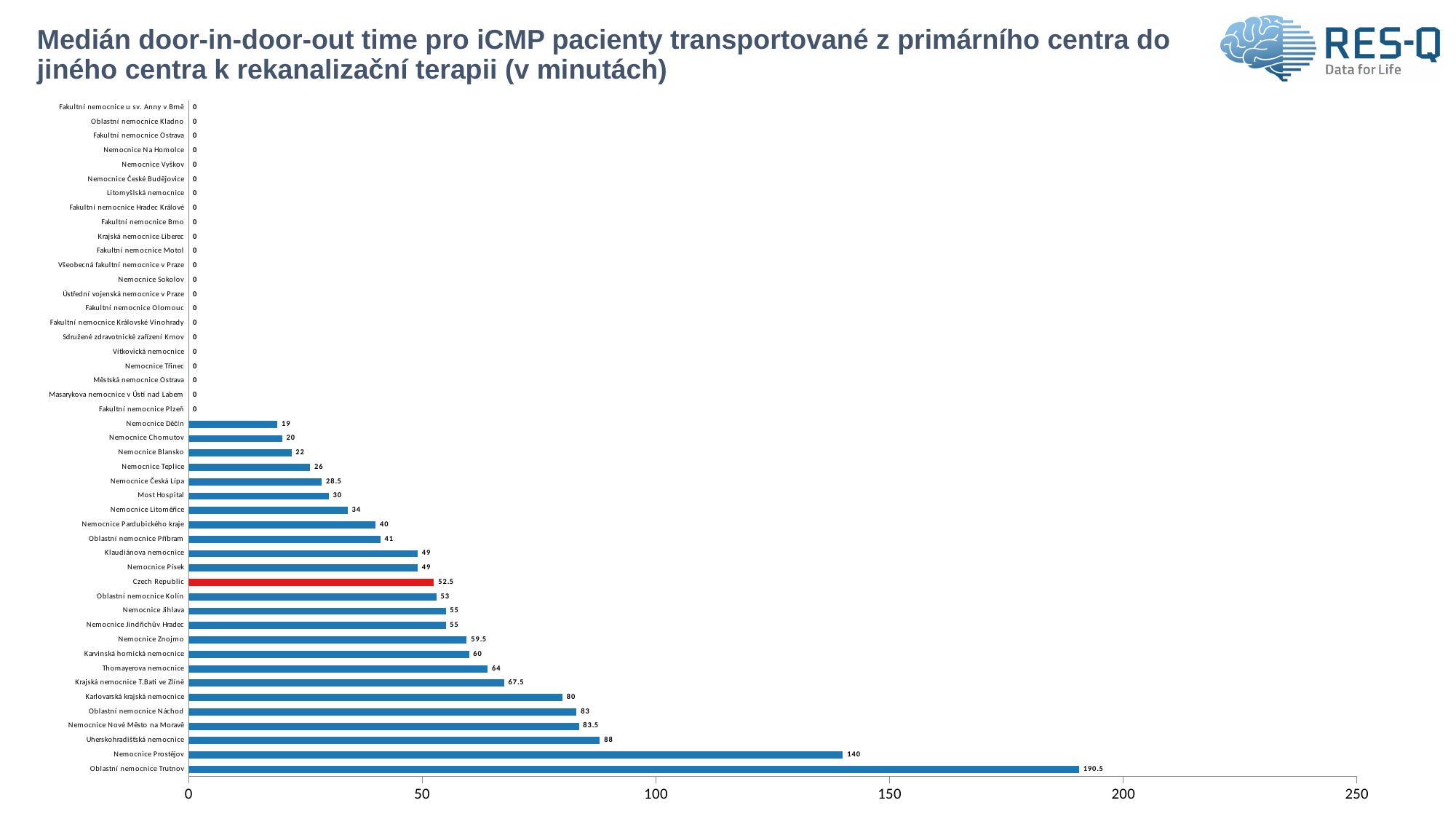
What is the median door-in-door-out time for Oblastní nemocnice Trutnov? 190.5 What is the difference between the values for Oblastní nemocnice Trutnov and Nemocnice Prostějov? 50.5 What is the value shown for Nemocnice Prostějov? 140 Which hospital has the highest median door-in-door-out time? Oblastní nemocnice Trutnov What is the value shown for Czech Republic? 52.5 Which bar is coloured red instead of blue? Czech Republic Which is larger, the value for Uherskohradišťská nemocnice or the value for Karlovarská krajská nemocnice? Uherskohradišťská nemocnice Among hospitals with a non-zero value, which has the lowest median door-in-door-out time? Nemocnice Děčín What is the value shown for Nemocnice Česká Lípa? 28.5 Is the value for Nemocnice Prostějov greater or less than 100? greater How many hospitals show a value of 0? 22 What kind of chart is shown on the slide? Bar chart